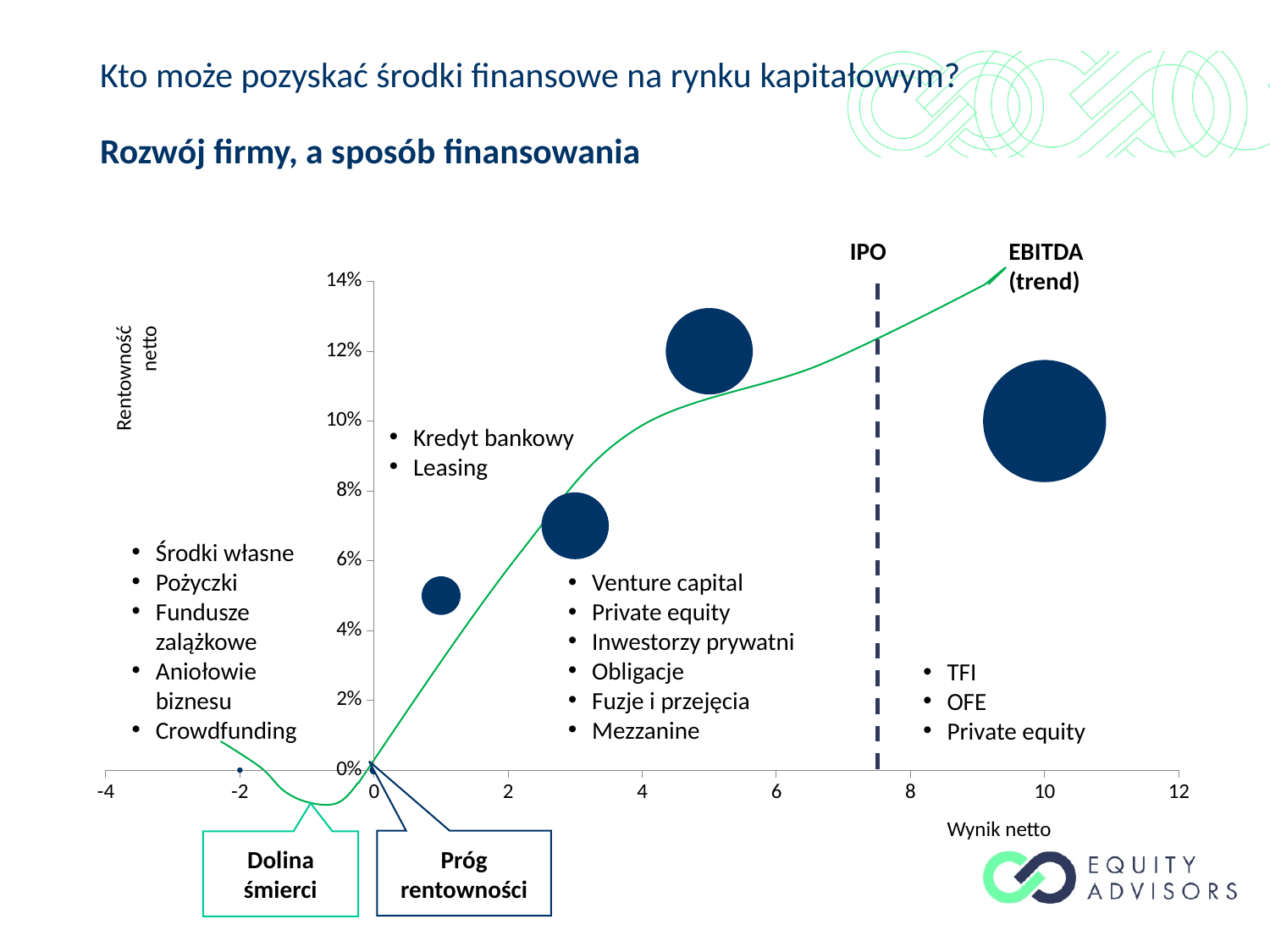
Which bubble has the highest Rentowność netto: the one near Wynik netto 5 or the one near Wynik netto 10? The one near Wynik netto 5 Is the Rentowność netto value of the bubble located near Wynik netto 1 greater or less than 6%? less Is the Rentowność netto value of the bubble located near Wynik netto 3 greater or less than 6%? greater What is the highest value shown on the vertical axis of the chart? 14% Is the Rentowność netto value of the bubble located near Wynik netto 3 greater or less than 8%? less What type of chart is shown on the slide? Bubble chart Which bubble is the largest in size on the chart? The bubble near Wynik netto 10 Does the green trend line rise or fall as Wynik netto increases from 0 to 10? Rises Which bubble has the lowest Rentowność netto: the one near Wynik netto 1 or the one near Wynik netto 3? The one near Wynik netto 1 What is the label of the horizontal axis of the chart? Wynik netto What is the label of the vertical axis of the chart? Rentowność netto